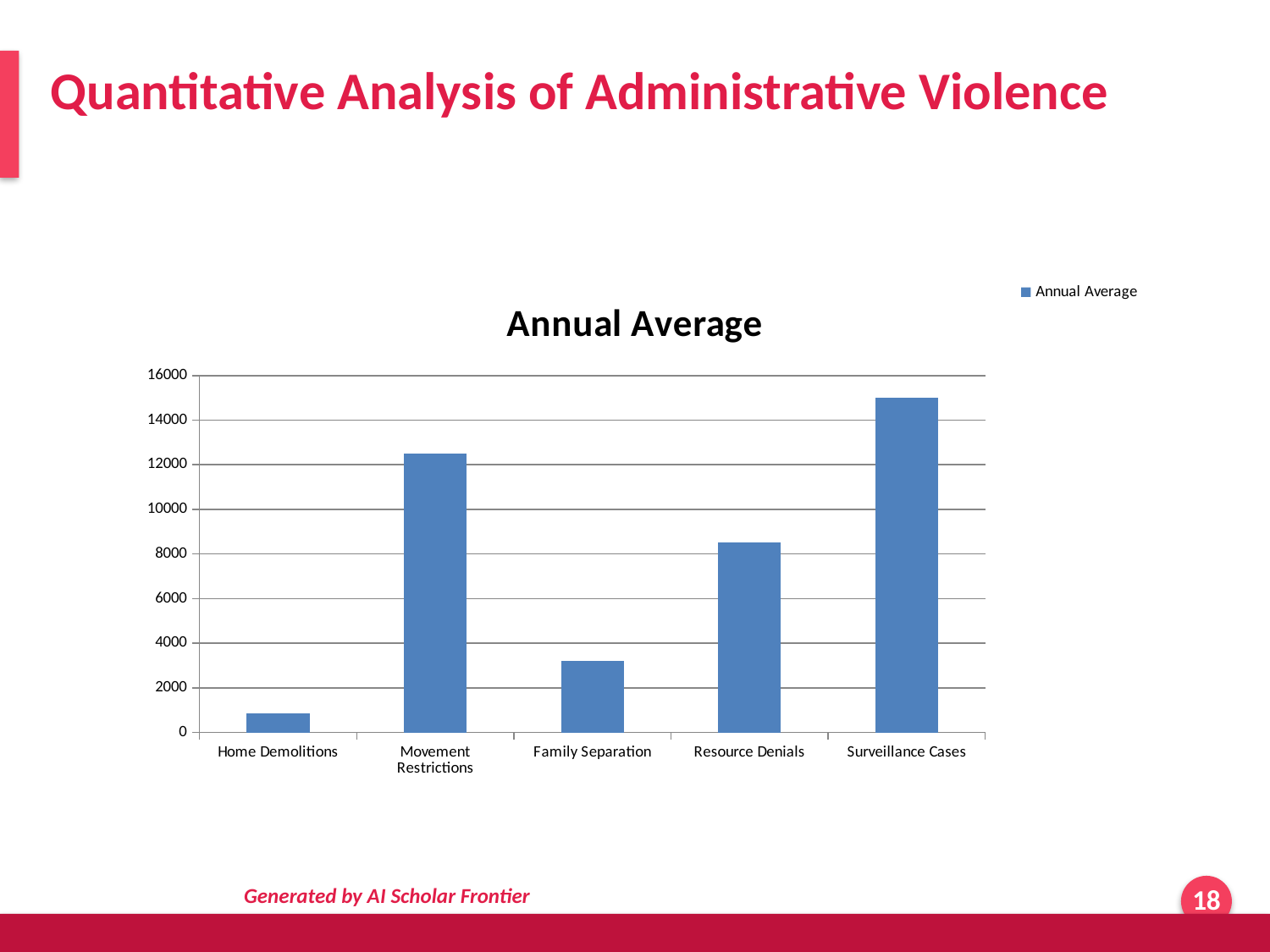
What is the title of the chart? Annual Average Which category has the lowest value in the chart? Home Demolitions Is the value for Movement Restrictions greater or less than 12000? greater Which category has the highest value in the chart? Surveillance Cases How many categories are shown on the x axis of the chart? 5 Which is larger, the value for Resource Denials or the value for Family Separation? Resource Denials What kind of chart is shown on the slide? bar chart Is the value for Resource Denials greater or less than 8000? greater Is the value for Family Separation greater or less than 4000? less What is the highest value shown on the y axis of the chart? 16000 How many series does the legend list? 1